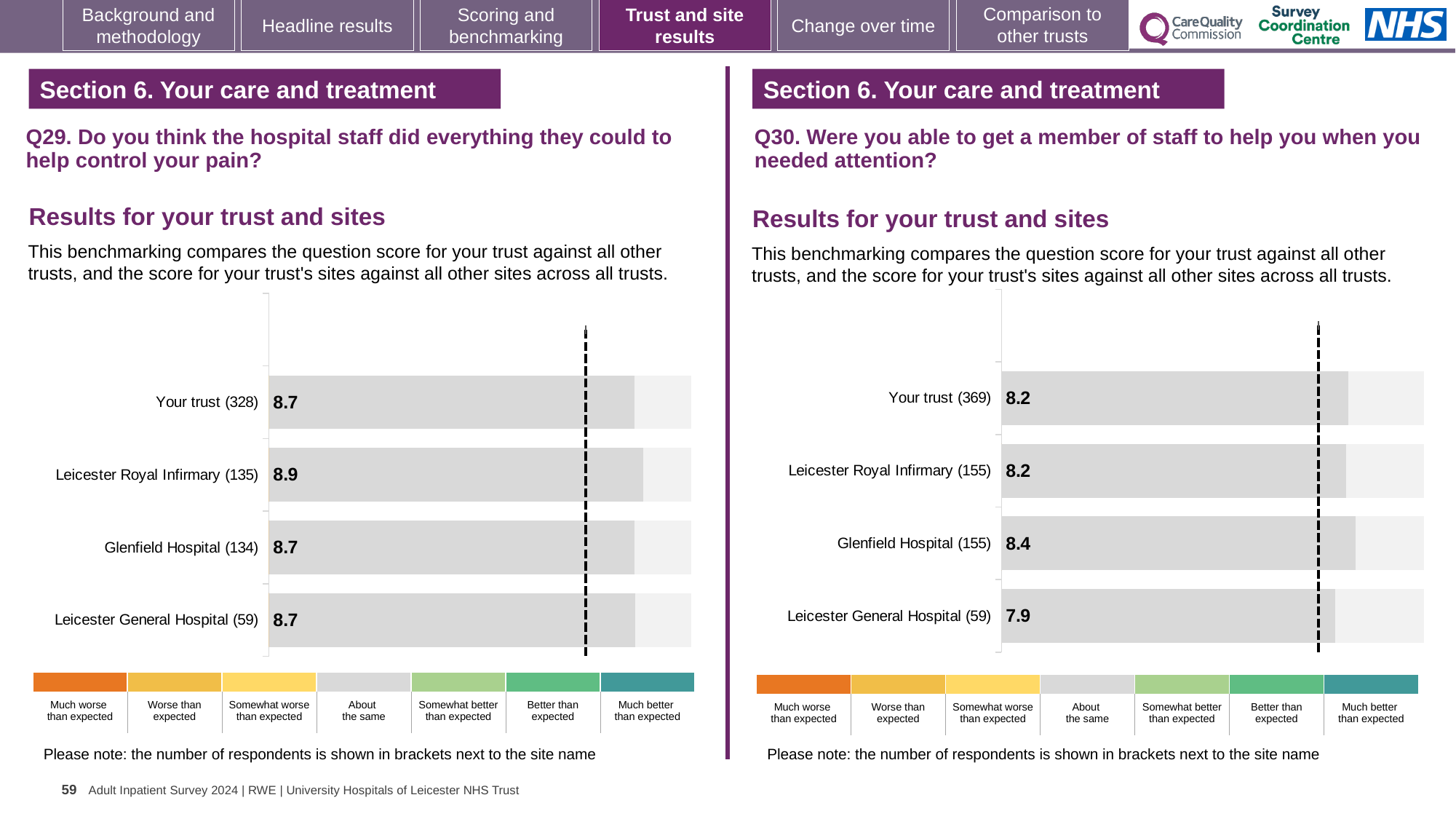
What type of chart is used for the Q29 results on the left? Bar chart In the Q29 chart on the left, what is the score for Your trust? 8.7 In the Q30 chart on the right, what is the score for Glenfield Hospital? 8.4 In the Q29 chart on the left, which site has the highest score? Leicester Royal Infirmary In the Q30 chart on the right, what is the score for Leicester General Hospital? 7.9 How many bars are plotted in the Q30 chart on the right? 4 In the Q30 chart on the right, what is the difference between the scores for Glenfield Hospital and Leicester General Hospital? 0.5 In the Q29 chart on the left, what is the score for Leicester Royal Infirmary? 8.9 In the Q30 chart on the right, which is larger, the score for Glenfield Hospital or the score for Your trust? Glenfield Hospital In the Q30 chart on the right, which site has the lowest score? Leicester General Hospital In the Q29 chart on the left, how many respondents are shown in brackets for Leicester General Hospital? 59 In the Q29 chart on the left, what is the difference between the scores for Leicester Royal Infirmary and Glenfield Hospital? 0.2